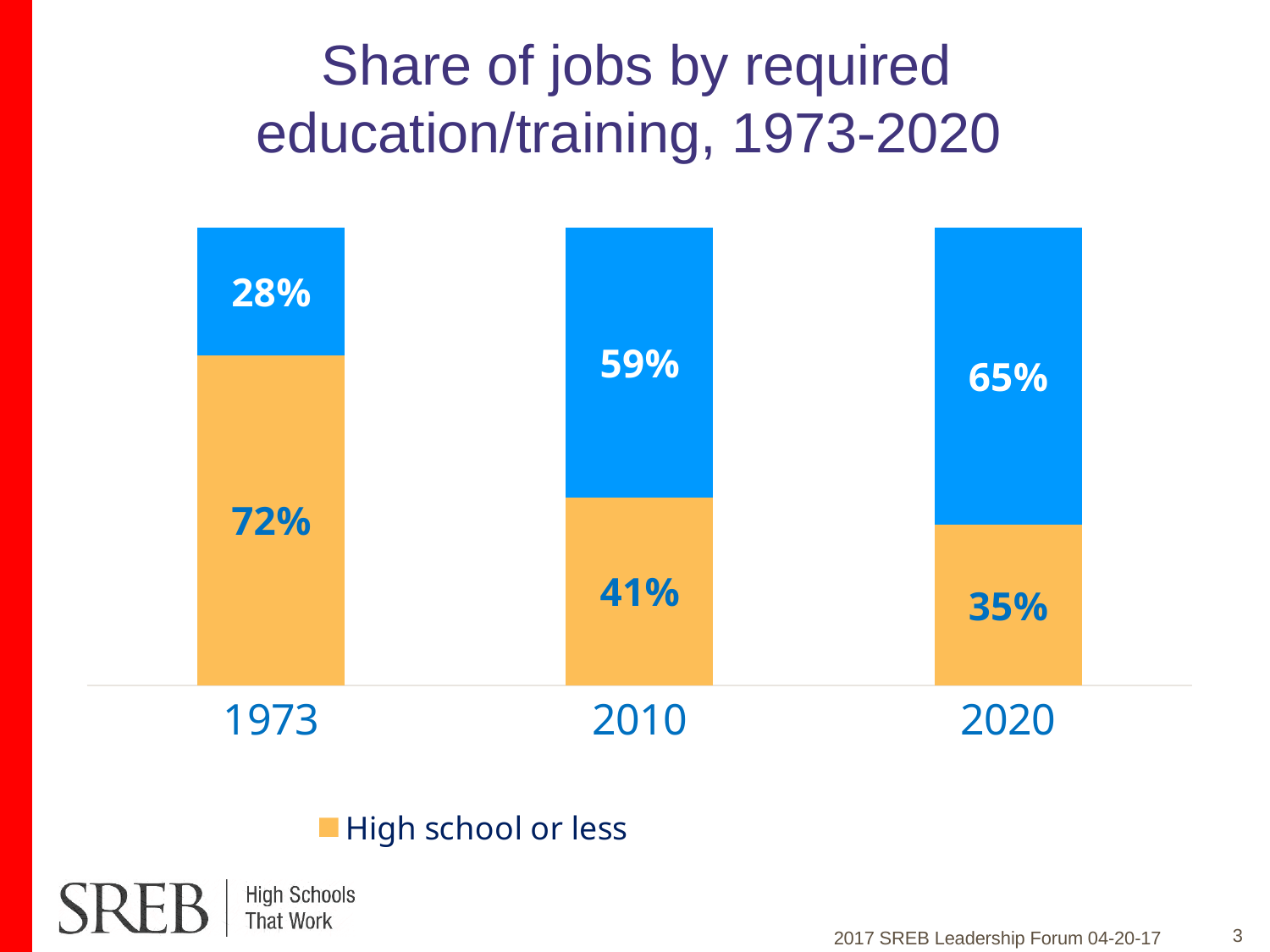
What is the difference between the High school or less share in 1973 and in 2010? 31% What is the value for High school or less in 1973? 72% What is the total of the stacked bar for 1973? 100% What is the value of the blue segment for 2010? 59% In which year is the High school or less share highest? 1973 In which year is the High school or less share lowest? 2020 Does the High school or less share rise or fall from 1973 to 2020? Fall What is the value of the blue segment for 2020? 65% How many years are shown on the x axis? 3 What is the value for High school or less in 2020? 35% What kind of chart is shown on the slide? Stacked bar chart Which is larger in 2010: the High school or less segment or the blue segment? The blue segment